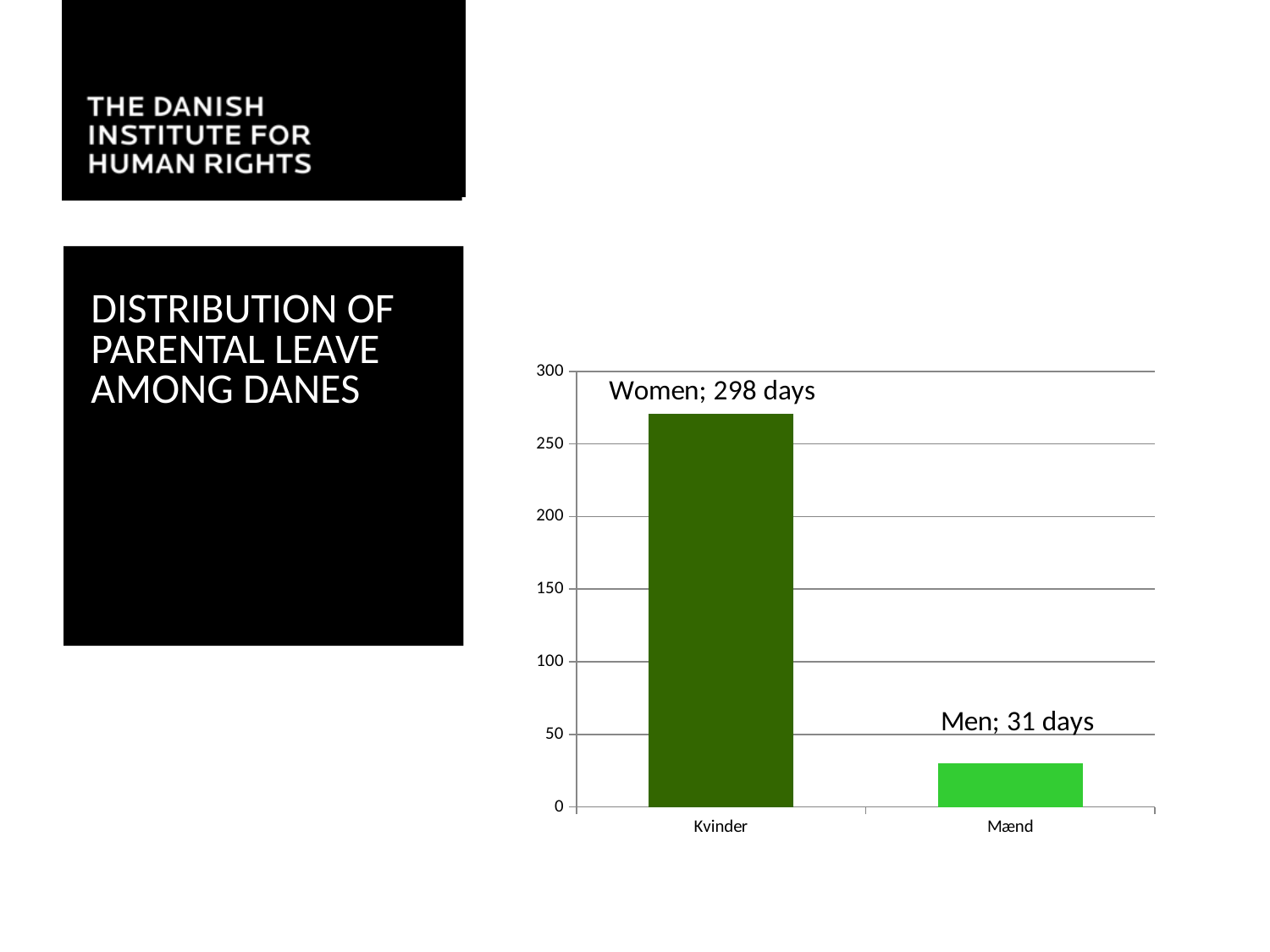
Is the value for Mænd greater or less than 50? less What kind of chart is shown on the slide? bar chart What is the difference between the labelled values for Women and Men? 267 days What value is labelled on the bar for Mænd (Men)? 31 days Which category has the highest value in the chart? Kvinder Which category has the lowest value in the chart? Mænd How many categories are plotted in the chart? 2 What is the title text shown to the left of the chart? DISTRIBUTION OF PARENTAL LEAVE AMONG DANES What is the highest tick value shown on the vertical axis? 300 Which is larger, the value for Kvinder or the value for Mænd? Kvinder What value is labelled on the bar for Kvinder (Women)? 298 days Is the value for Kvinder greater or less than 250? greater